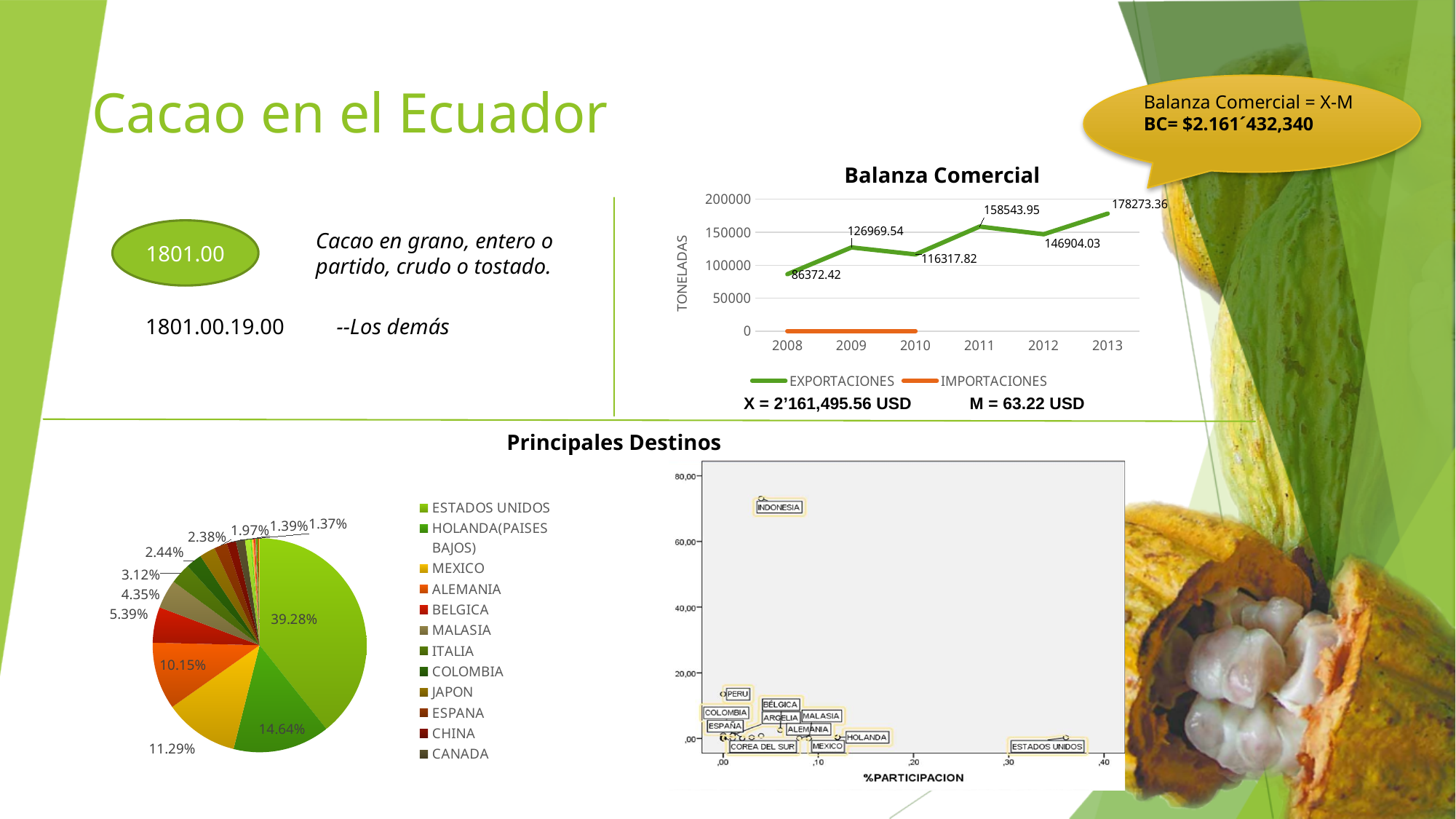
In the Principales Destinos pie chart, what share does ESTADOS UNIDOS have? 39.28% In the Balanza Comercial chart, which year has the highest EXPORTACIONES value? 2013 In the Balanza Comercial chart, what is the EXPORTACIONES value for 2013? 178273.36 In the Balanza Comercial chart, what is the EXPORTACIONES value for 2008? 86372.42 In the Principales Destinos pie chart, what share does HOLANDA(PAISES BAJOS) have? 14.64% What kind of chart is the Balanza Comercial chart? line chart In the Balanza Comercial chart, what is the difference between the EXPORTACIONES values for 2013 and 2012? 31369.33 In the Balanza Comercial chart, which year has the larger EXPORTACIONES value, 2009 or 2010? 2009 In the Principales Destinos pie chart, how many countries does the legend list? 12 In the Balanza Comercial chart, how many series does the legend list? 2 In the Balanza Comercial chart, which year has the lowest EXPORTACIONES value? 2008 In the scatter plot at the bottom right, which country is plotted highest on the vertical axis? INDONESIA